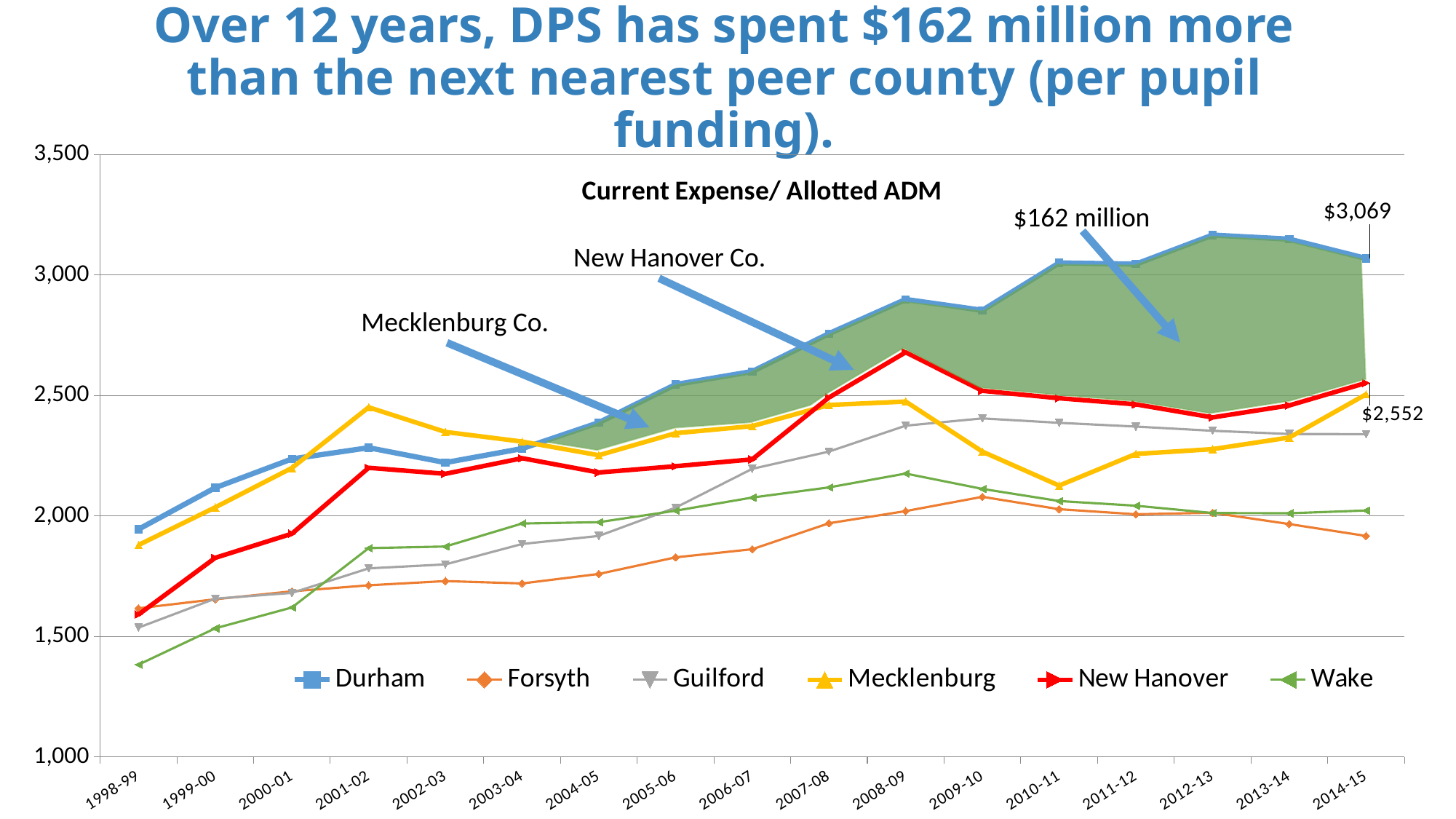
What is the labelled value for Durham in 2014-15? $3,069 Is the value for Durham in 2012-13 greater or less than 3,000? greater In 2001-02, which is larger: Mecklenburg or New Hanover? Mecklenburg What kind of chart is shown on the slide? Line chart Which county has the lowest value in 1998-99? Wake How many series does the legend list? 6 What is the difference between the two data labels shown at the right edge of the chart, $3,069 and $2,552? $517 How many school years are shown along the x axis? 17 Does the Durham line generally rise or fall from 1998-99 to 2014-15? Rise Which county has the lowest value in 2014-15? Forsyth Which county has the highest value in 2014-15? Durham Is the value for Wake in 1998-99 greater or less than 1,500? less